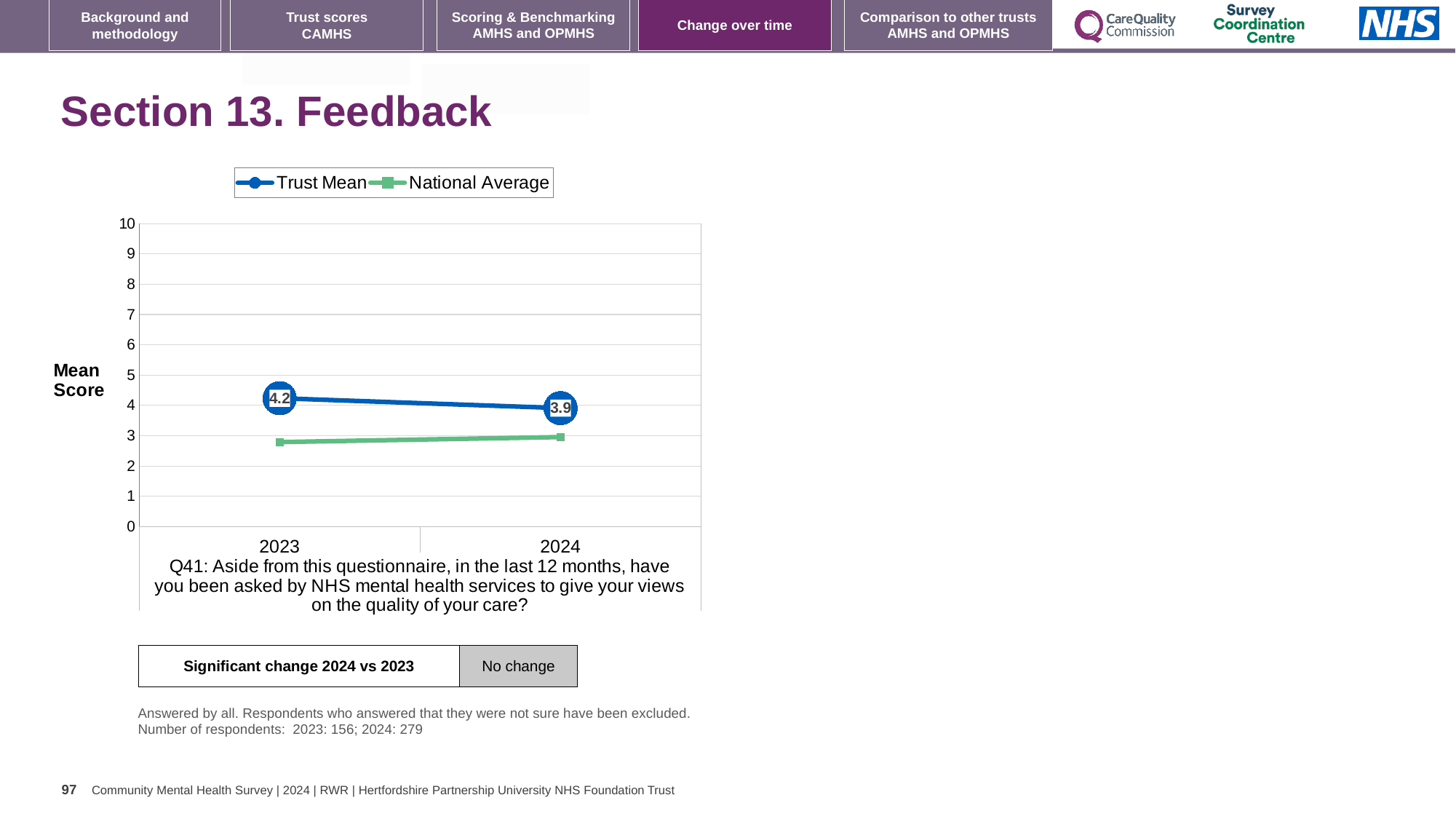
Does the National Average rise or fall from 2023 to 2024? rise In 2024, which series is higher, Trust Mean or National Average? Trust Mean Is the National Average value for 2023 greater or less than 3? less Which year has the higher Trust Mean, 2023 or 2024? 2023 Is the Trust Mean value for 2024 greater or less than 5? less How many years are shown on the x axis? 2 How many series does the legend list? 2 What is the Trust Mean value for 2024? 3.9 What is the difference between the Trust Mean in 2023 and in 2024? 0.3 What is the Trust Mean value for 2023? 4.2 Does the Trust Mean rise or fall from 2023 to 2024? fall What kind of chart is shown on the slide? line chart